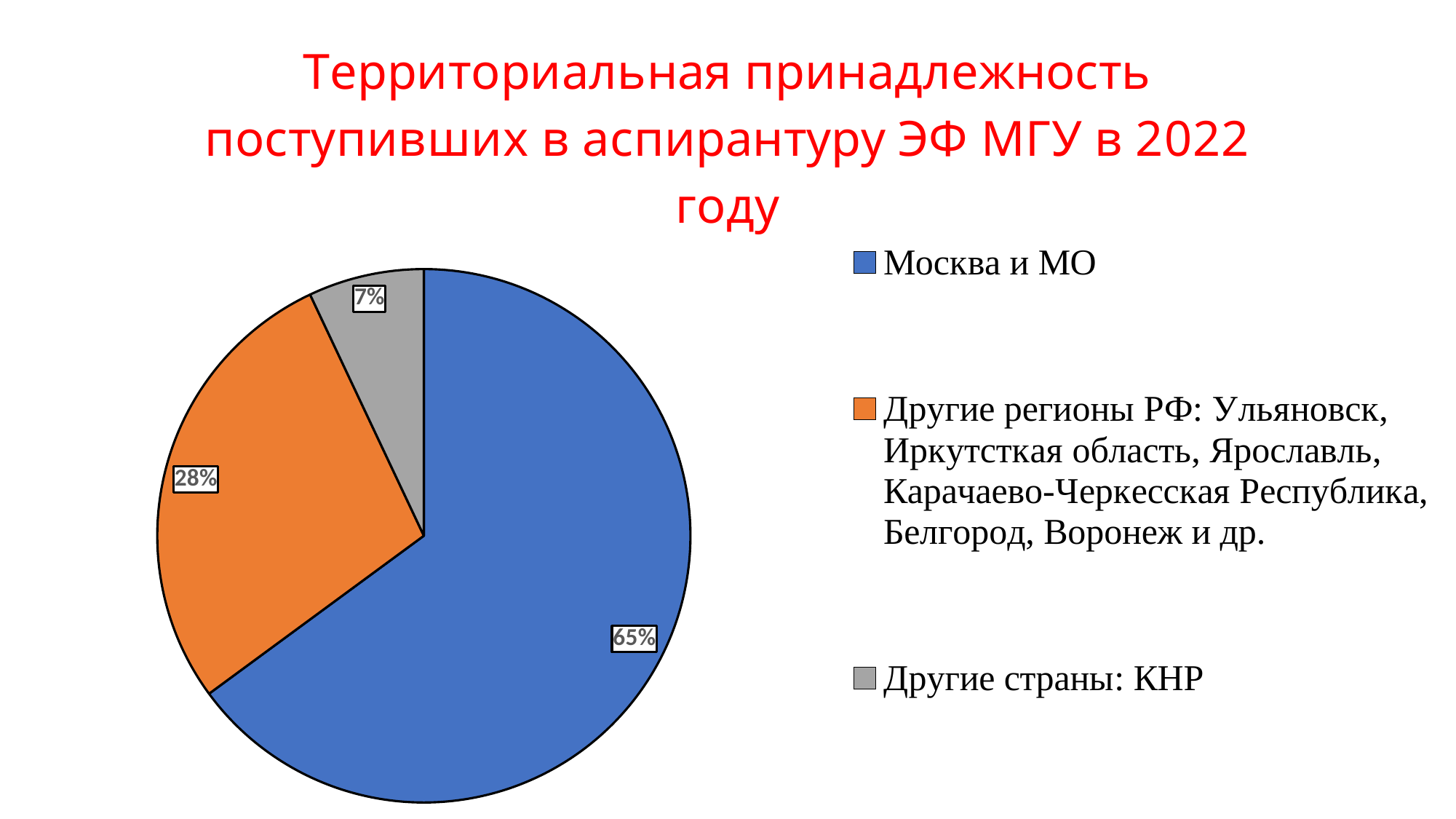
What colour is the slice for Москва и МО? Blue What share of the pie does Москва и МО account for? 65% What percentage is shown for the Другие регионы РФ slice? 28% What is the title of the chart? Территориальная принадлежность поступивших в аспирантуру ЭФ МГУ в 2022 году What kind of chart is shown on the slide? Pie chart Which is larger: the share for Другие регионы РФ or the share for Другие страны: КНР? Другие регионы РФ What percentage is shown for Другие страны: КНР? 7% Which category has the largest slice of the pie? Москва и МО What is the difference in percentage points between Москва и МО and Другие регионы РФ? 37 What is the difference in percentage points between Другие регионы РФ and Другие страны: КНР? 21 How many slices does the pie chart have? 3 Which category has the smallest slice of the pie? Другие страны: КНР